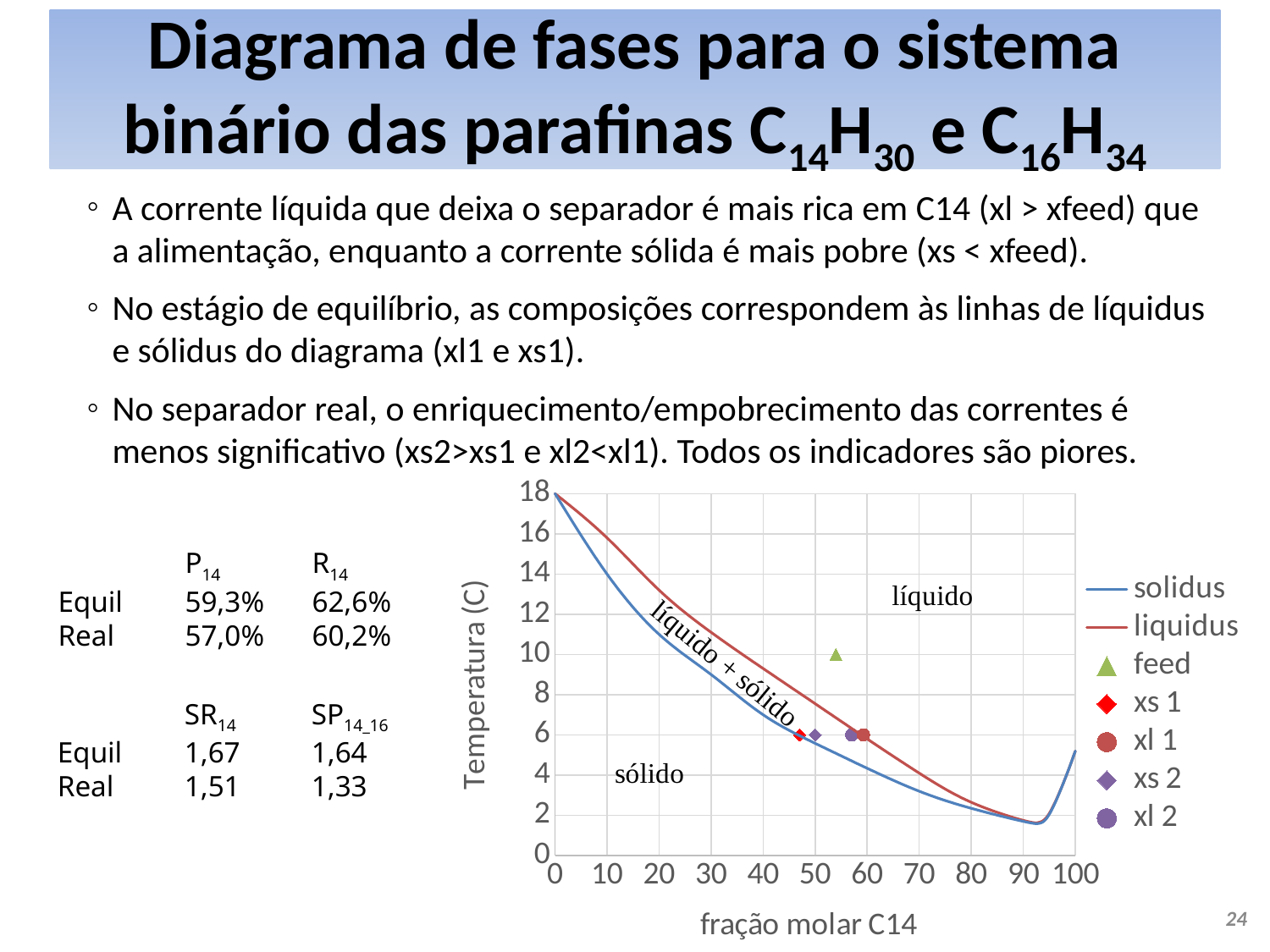
Which has a larger molar fraction of C14, the xs 1 point or the xl 1 point? xl 1 How many series does the chart legend list? 7 Which plotted point has the lowest molar fraction of C14? xs 1 What kind of chart is shown on the slide? line chart At molar fraction 0, what temperature do the solidus and liquidus lines start from? 18 Is the temperature of the xs 1 point greater or less than 8? less Which plotted point has the highest temperature? feed Is the temperature of the feed point greater or less than 8? greater Does the liquidus line rise or fall as the molar fraction of C14 increases from 0 to 80? fall Is the temperature of the solidus line at molar fraction 100 greater or less than 4? greater What is the title of the x axis of the chart? fração molar C14 What is the title of the y axis of the chart? Temperatura (C)